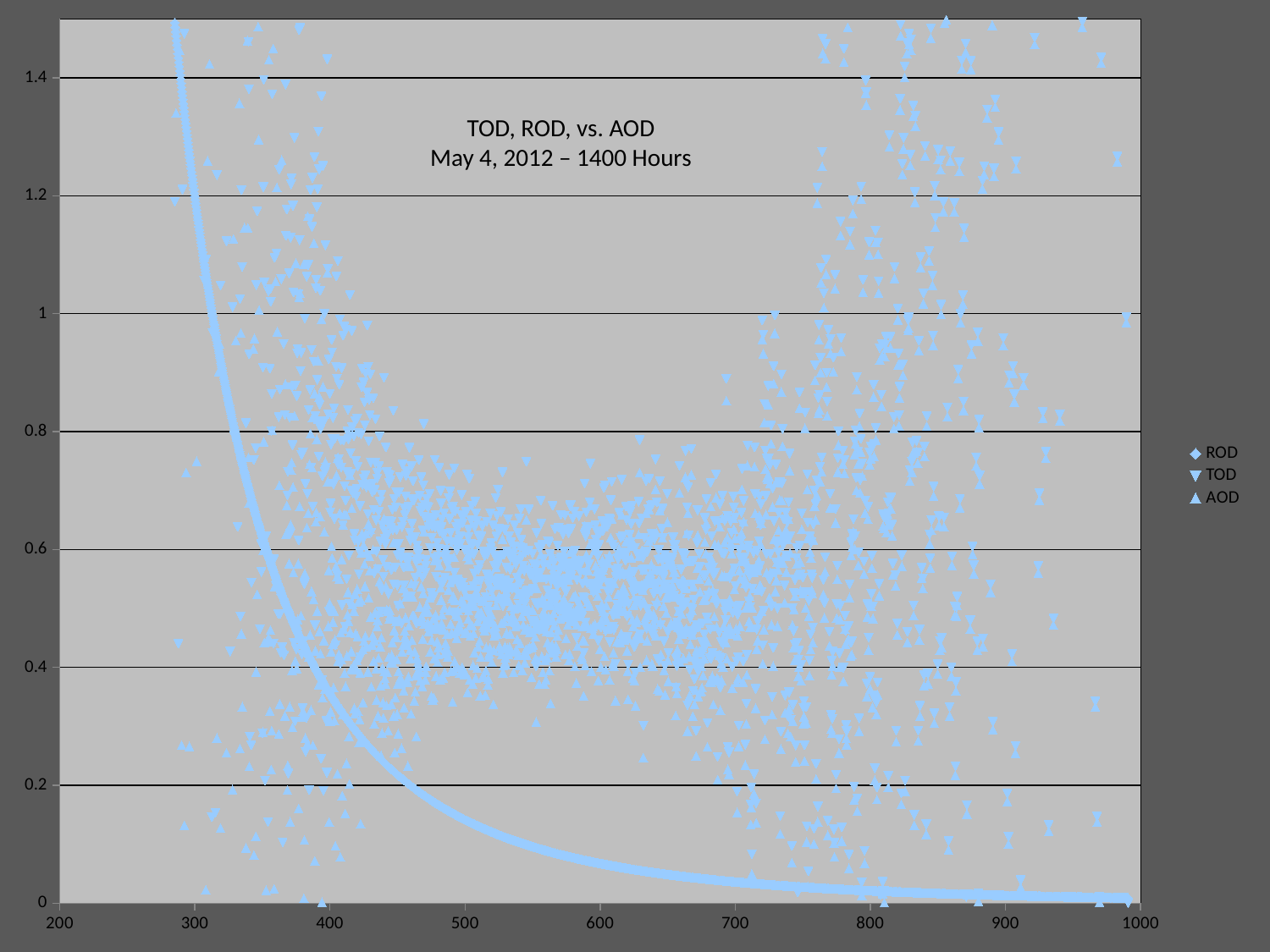
What is the title of the chart? TOD, ROD, vs. AOD May 4, 2012 – 1400 Hours Does the ROD series rise or fall as the x-axis value increases? Fall What kind of chart is shown on the slide? Scatter chart Which series are listed in the legend? ROD, TOD, AOD Is the ROD value at x = 500 greater or less than 0.4? less Is the ROD value at x = 400 greater or less than 0.6? less Is the ROD value at x = 300 greater or less than 0.8? greater How many series does the legend list? 3